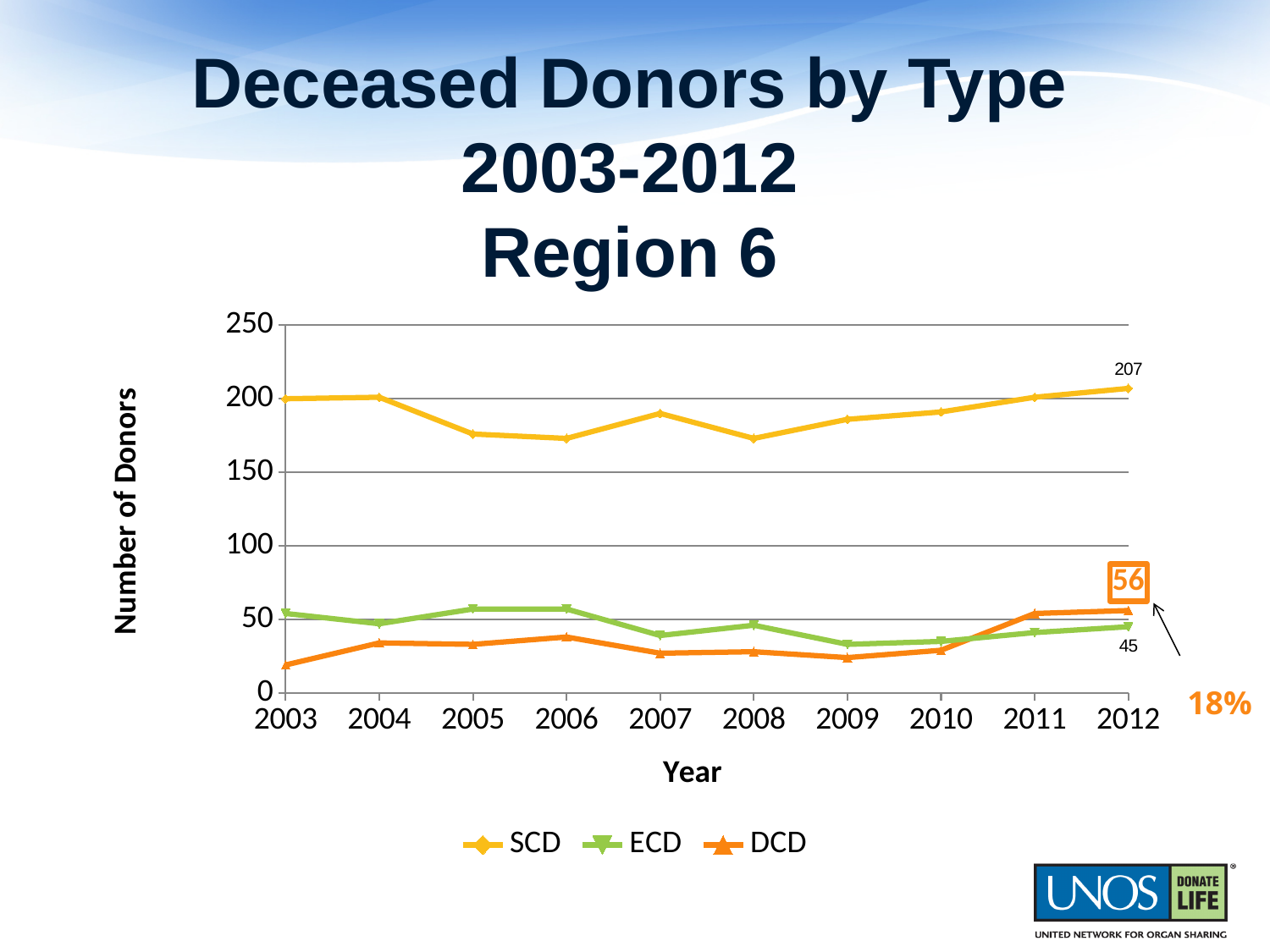
What is the value for ECD in 2012? 45 Which series has the lowest value in 2003? DCD How many years are shown on the x axis? 10 Is the value for SCD in 2005 greater or less than 200? less What is the difference between the DCD and ECD values in 2012? 11 What is the value for SCD in 2012? 207 How many series does the legend list? 3 What kind of chart is shown on the slide? line chart Is the value for DCD in 2003 greater or less than 50? less What is the difference between the SCD and DCD values in 2012? 151 In 2012, which is larger, DCD or ECD? DCD What is the value for DCD in 2012? 56